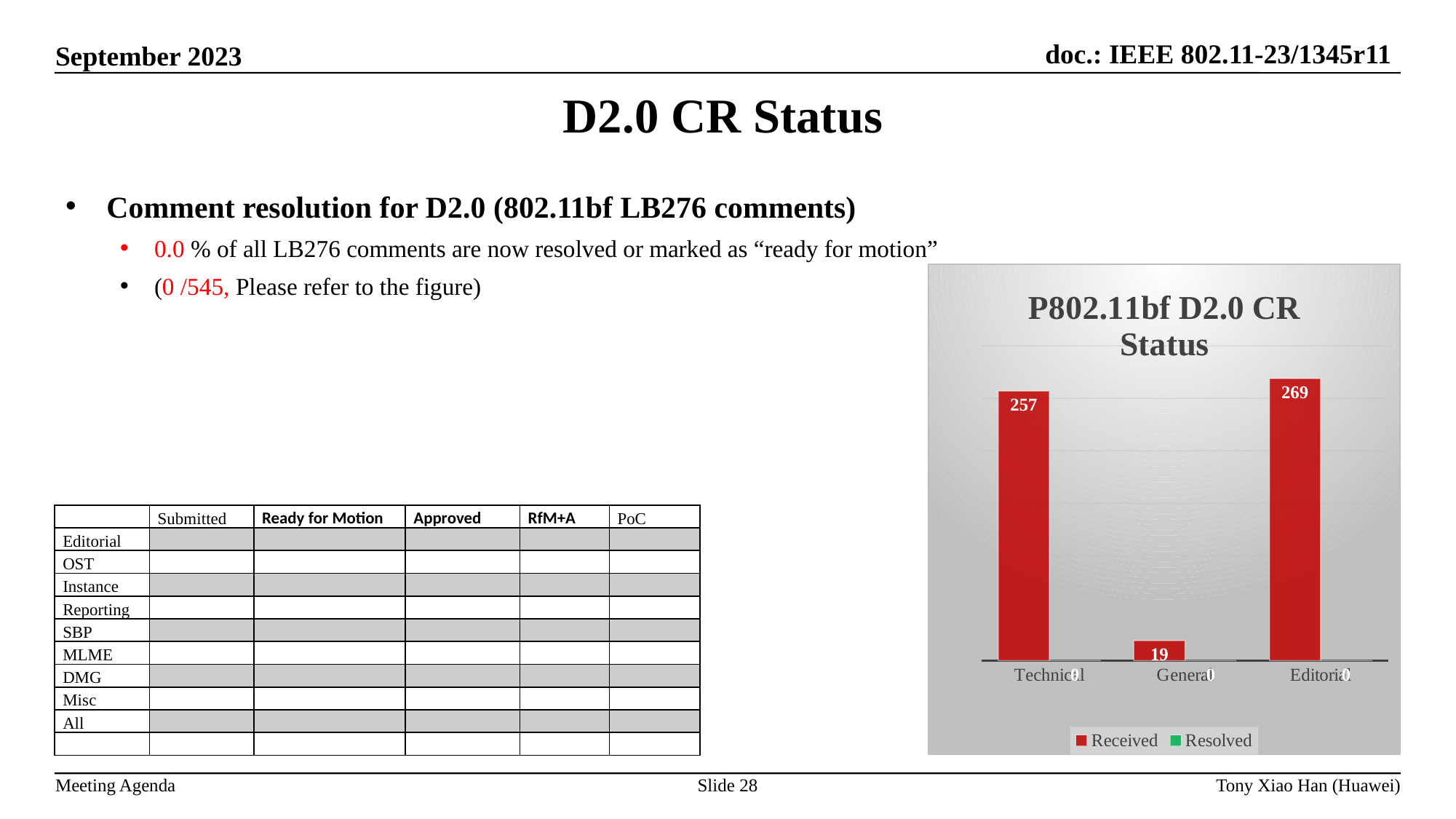
What kind of chart is the P802.11bf D2.0 CR Status chart? Bar chart How many categories are shown on the x axis of the P802.11bf D2.0 CR Status chart? 3 Which category has the highest Received value in the P802.11bf D2.0 CR Status chart? Editorial How many series does the legend of the P802.11bf D2.0 CR Status chart list? 2 In the P802.11bf D2.0 CR Status chart, is the Received value larger for Technical or for General? Technical What is the Received value for Editorial in the P802.11bf D2.0 CR Status chart? 269 Which category has the lowest Received value in the P802.11bf D2.0 CR Status chart? General What is the difference between the Received values for Technical and General in the P802.11bf D2.0 CR Status chart? 238 What are the two series named in the legend of the P802.11bf D2.0 CR Status chart? Received and Resolved What is the Received value for Technical in the P802.11bf D2.0 CR Status chart? 257 What is the difference between the Received values for Editorial and Technical in the P802.11bf D2.0 CR Status chart? 12 What is the Received value for General in the P802.11bf D2.0 CR Status chart? 19